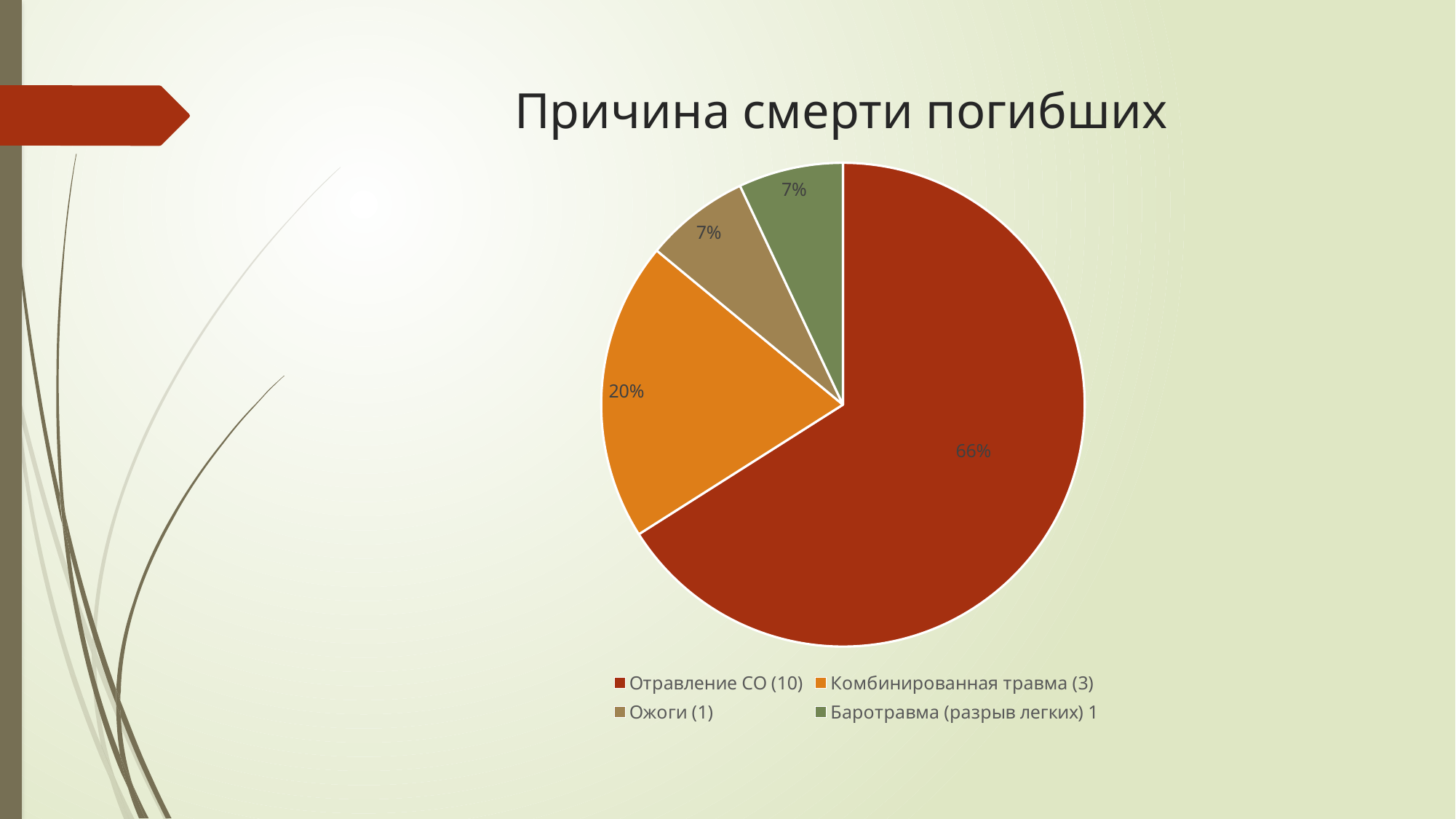
How many entries does the legend list? 4 What is the difference in percentage points between the Отравление СО (10) slice and the Комбинированная травма (3) slice? 46% What share of the pie does Баротравма (разрыв легких) 1 take? 7% What type of chart is shown on the slide? pie chart What is the title of the chart? Причина смерти погибших What colour is the slice for Комбинированная травма (3)? orange Which slice is larger: Комбинированная травма (3) or Ожоги (1)? Комбинированная травма (3) How many slices does the pie chart have? 4 What share of the pie does Отравление СО (10) take? 66% Which category has the largest slice of the pie? Отравление СО (10) What share of the pie does Ожоги (1) take? 7%